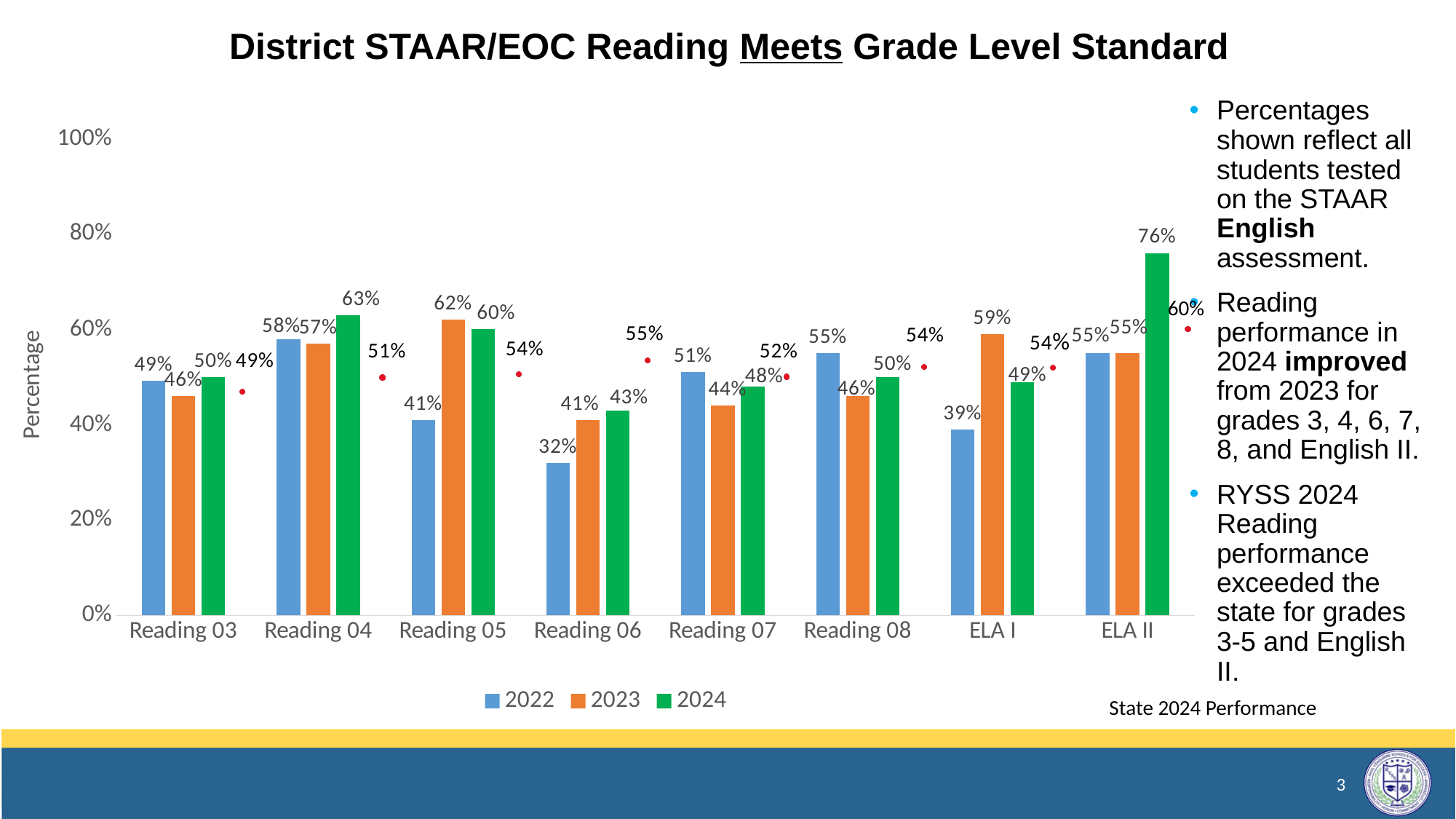
What kind of chart is shown on the slide? Bar chart How many categories are shown on the x axis? 8 What is the title of the chart? District STAAR/EOC Reading Meets Grade Level Standard What is the 2022 value for Reading 06? 32% What is the 2024 value for ELA II? 76% How many series does the legend list? 3 Which category has the lowest 2022 value? Reading 06 For Reading 08, which is larger: the 2022 value or the 2024 value? 2022 What is the difference between the 2024 and 2023 values for ELA II? 21 percentage points What is the difference between the 2023 and 2022 values for Reading 05? 21 percentage points What is the 2023 value for ELA I? 59% Which category has the highest 2024 value? ELA II